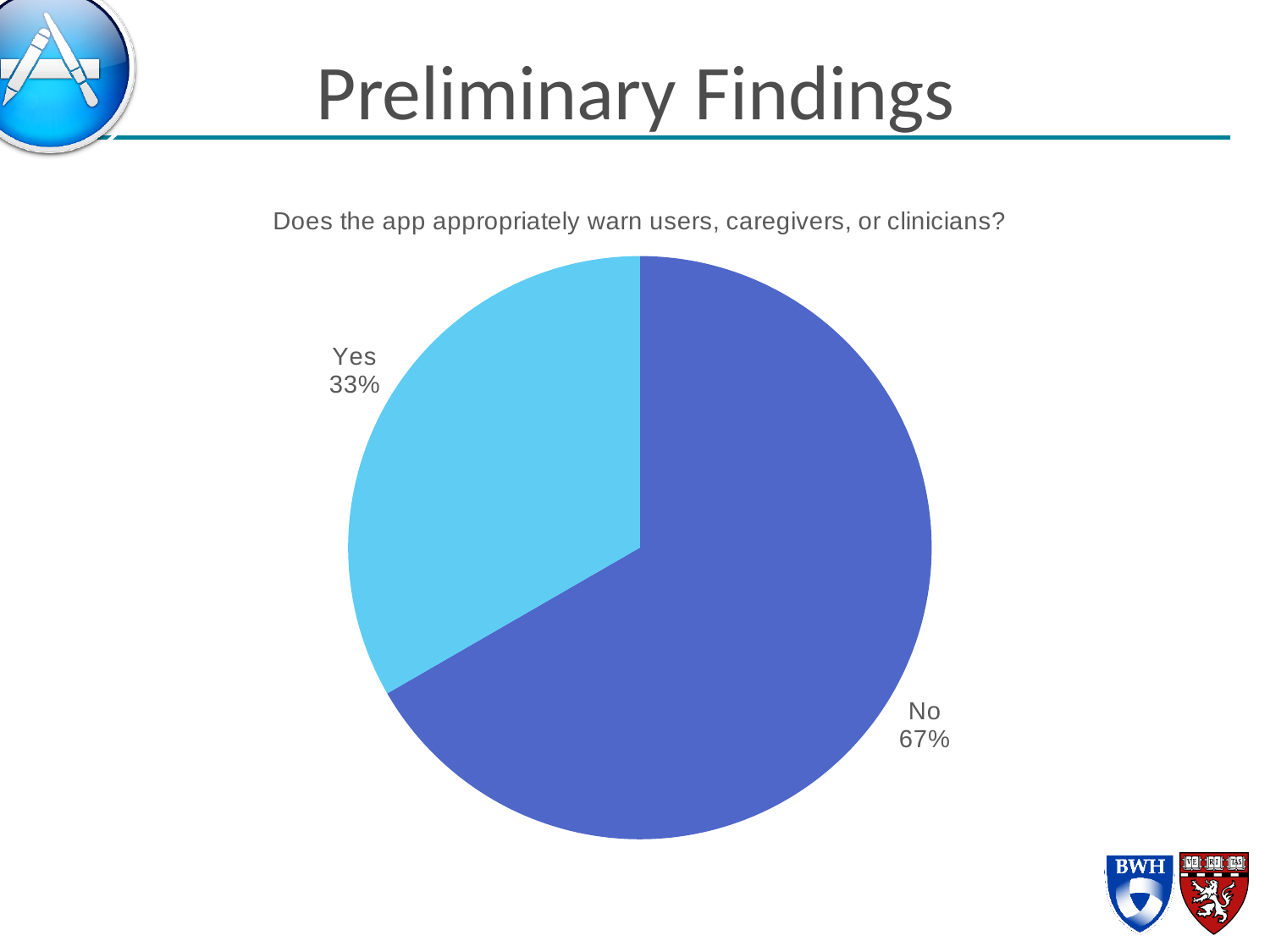
How many slices does the pie chart have? 2 What is the difference in percentage points between the "No" and "Yes" slices? 34 What colour is the "Yes" slice of the pie chart? light blue What percentage of apps answered "No" to appropriately warning users, caregivers, or clinicians? 67% What question does the chart title ask? Does the app appropriately warn users, caregivers, or clinicians? Which slice of the pie chart is the smallest? Yes What kind of chart is shown on the slide? pie chart Which is larger, the "Yes" slice or the "No" slice? No Which slice of the pie chart is the largest? No What share of the pie does the "Yes" slice represent? 33% What percentage of apps answered "Yes" to appropriately warning users, caregivers, or clinicians? 33%